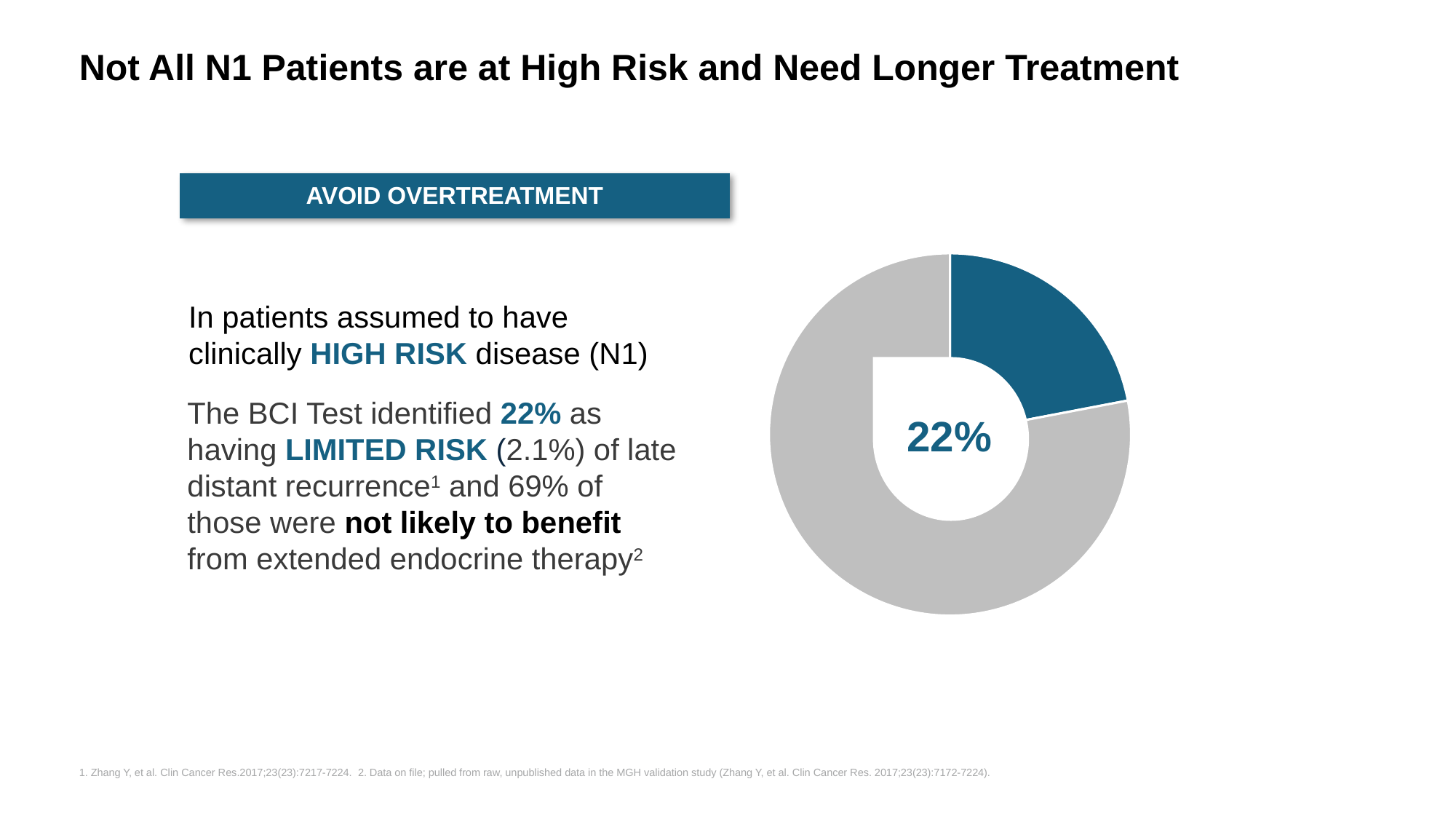
What percentage is printed in the centre of the donut chart? 22% According to the slide text, what does the 22% slice of the donut chart represent? Patients identified by the BCI Test as having limited risk What kind of chart is shown on the slide? Donut (pie) chart What share of the donut chart does the grey slice represent? 78% What share of the donut chart does the dark blue slice represent? 22% Is the share of the dark blue slice in the donut chart greater or less than 50%? less How many slices does the donut chart have? 2 What colour is the slice of the donut chart that is labelled 22%? Dark blue Which slice of the donut chart is larger, the dark blue one or the grey one? The grey one